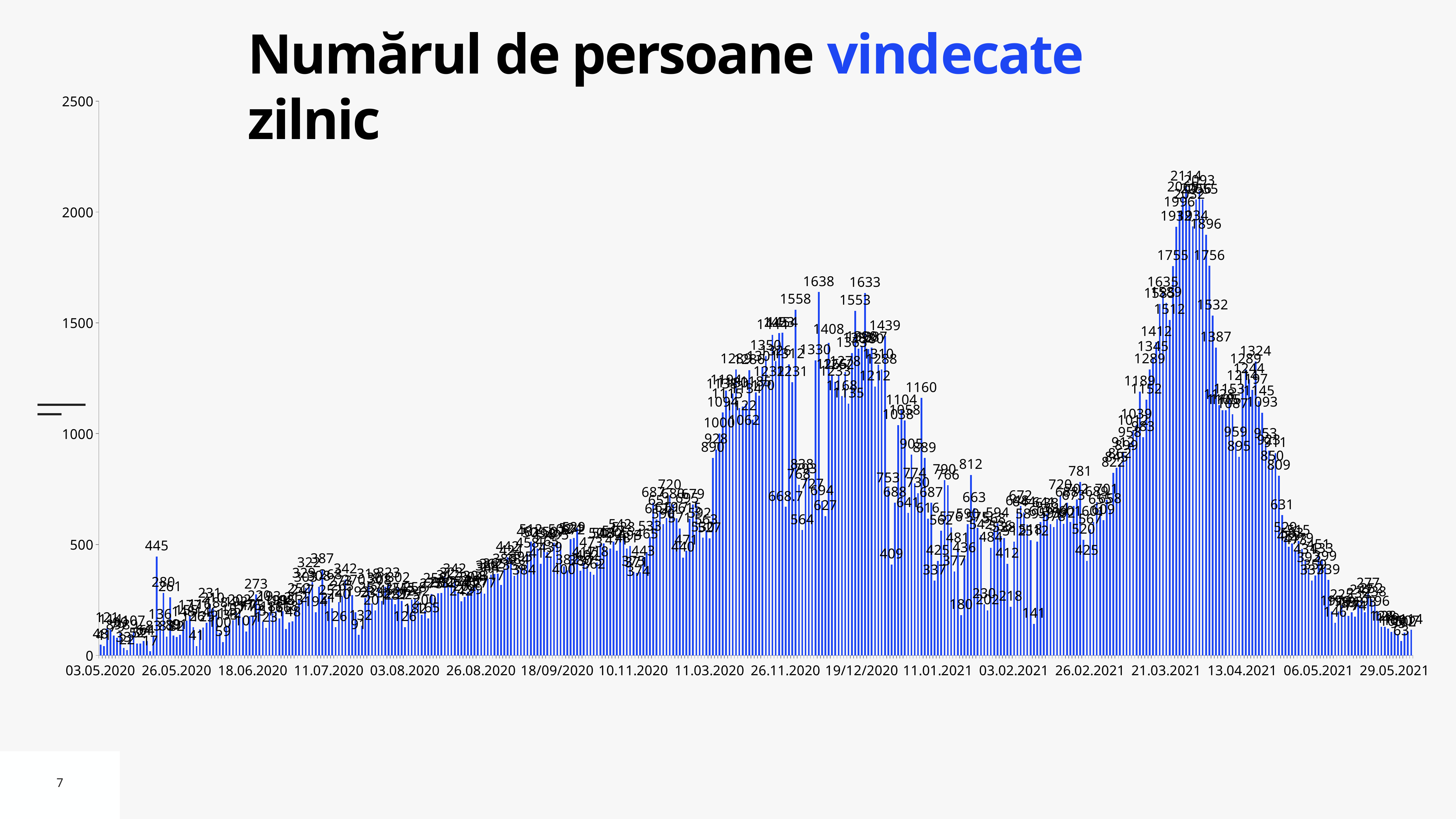
What is the highest tick value shown on the y axis? 2500 Are the bars around 03.02.2021 greater or less than 1000? less What is the difference between the overall peak value of 2114 and the late-2020 peak value of 1638? 476 Are the bars around 21.03.2021 greater or less than 1500? greater What kind of chart is shown on the slide? bar chart Is the value for the first date, 03.05.2020, greater or less than 500? less What is the highest value labelled on the chart? 2114 Do the values rise or fall along the x axis from 21.03.2021 to 29.05.2021? fall What is the title of the chart? Numărul de persoane vindecate zilnic Which is larger, the peak of 2114 in March 2021 or the peak of 1638 in late 2020? 2114